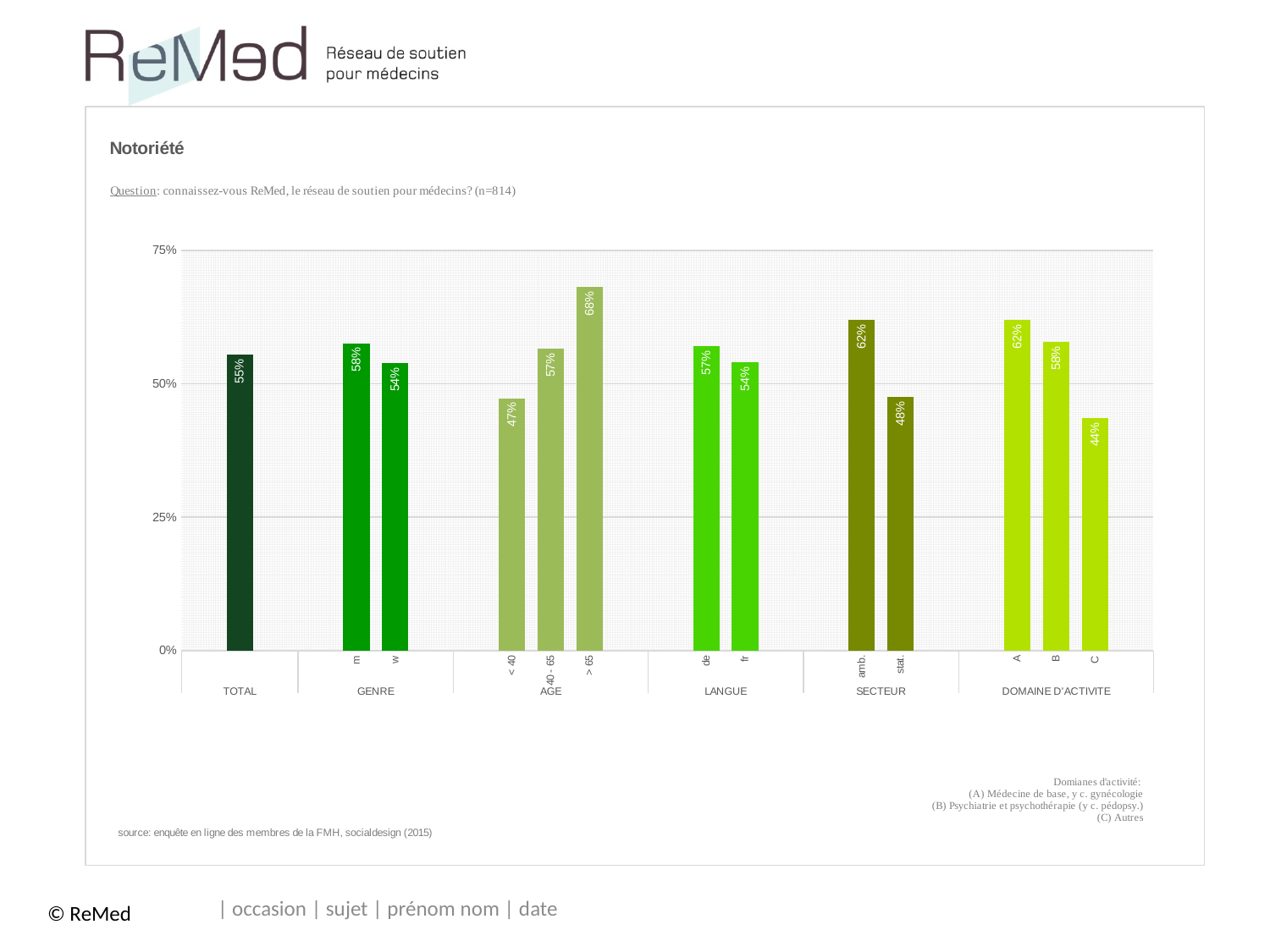
Which bar has the lowest value on the chart? C (DOMAINE D'ACTIVITE) What is the value for the '> 65' age group? 68% What is the difference between the values for 'm' and 'w' in the GENRE group? 4% Is the value for '< 40' greater or less than 50%? less What kind of chart is shown on the slide? bar chart What is the value for 'stat.' in the SECTEUR group? 48% What is the difference between 'amb.' and 'stat.' in the SECTEUR group? 14% Which is larger, the value for 'de' or the value for 'fr' in the LANGUE group? de What is the value for 'C' in the DOMAINE D'ACTIVITE group? 44% How many bars are plotted on the chart? 13 What is the value for TOTAL? 55% Which bar has the highest value on the chart? > 65 (AGE)